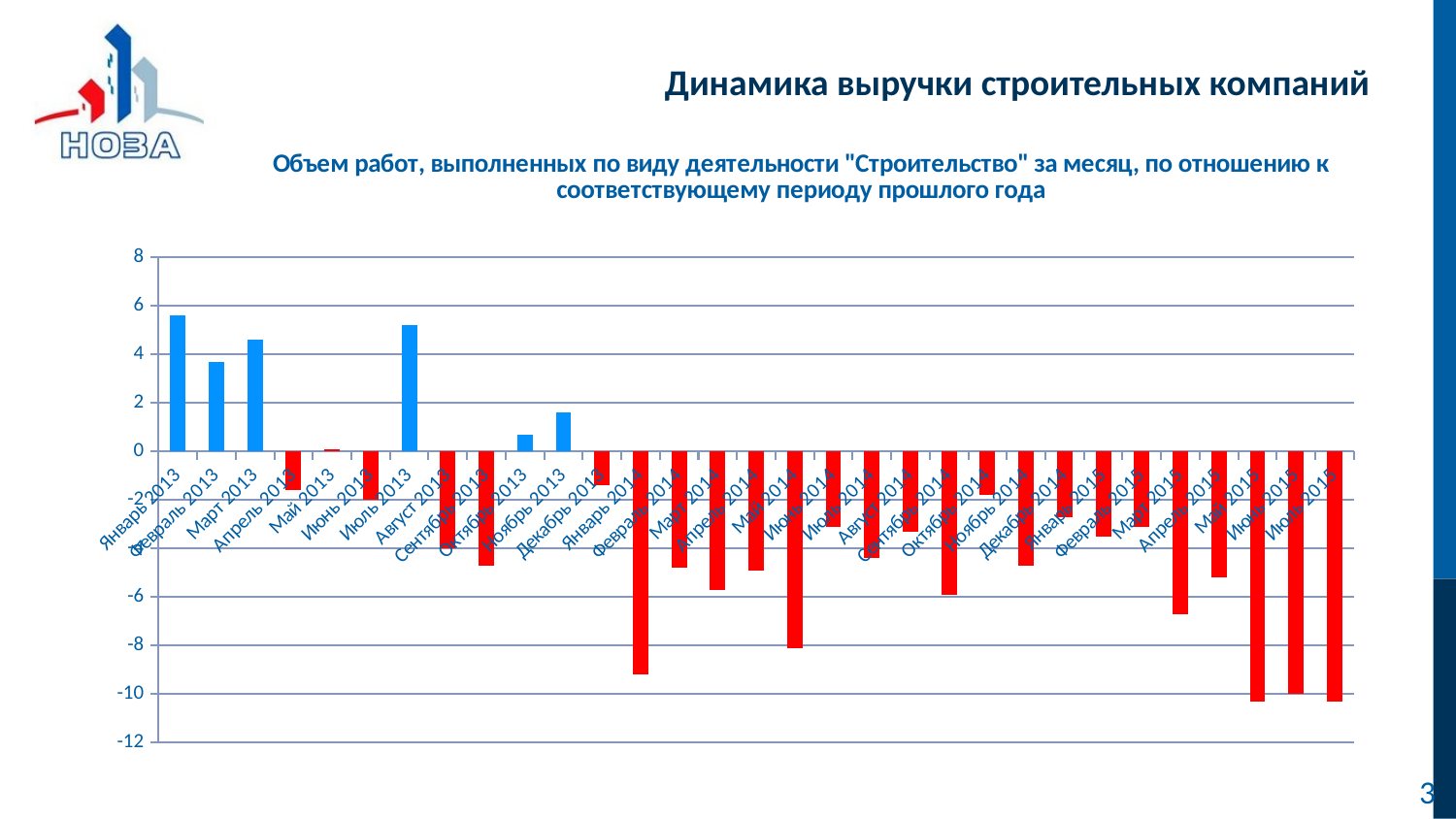
How many months (categories) are plotted on the x axis? 31 Is the value for Март 2015 greater or less than -6? less Do the values generally rise or fall from 2013 to 2015 along the x axis? fall Is the value for Январь 2013 greater or less than 4? greater Is the value for Январь 2014 greater or less than -8? less Which month has the highest value on the chart? Январь 2013 What kind of chart is shown on the slide? bar chart What is the title of the slide? Динамика выручки строительных компаний Which is larger, the value for Январь 2013 or the value for Февраль 2013? Январь 2013 What colour are the bars with negative values? red Which is larger, the value for Январь 2014 or the value for Февраль 2014? Февраль 2014